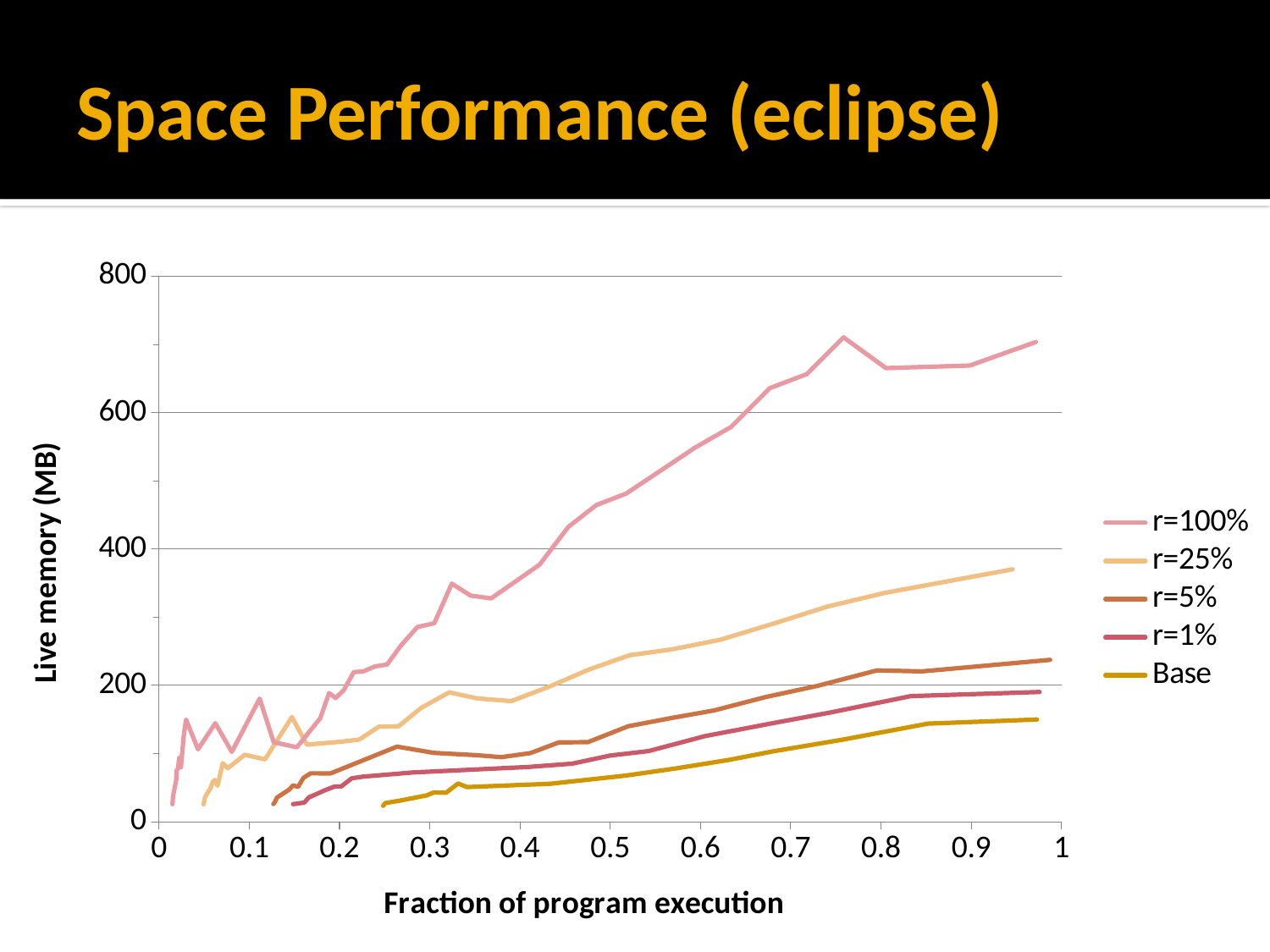
At a fraction of 0.9, is the live memory for r=100% greater or less than 600? greater What kind of chart is shown on the slide? line chart At a fraction of 0.9, is the live memory for Base greater or less than 200? less At a fraction of 0.9, is the live memory for r=25% greater or less than 400? less Which series has the lowest live memory at the end of program execution? Base At a fraction of 0.9, which series has higher live memory, r=100% or Base? r=100% Which series reaches the highest live memory on the chart? r=100% Does the r=100% line generally rise or fall as the fraction of program execution increases? rise How many series does the legend list? 5 At a fraction of 0.5, which series has higher live memory, r=5% or r=1%? r=5% What is the title of the vertical axis? Live memory (MB) What is the title of the horizontal axis? Fraction of program execution